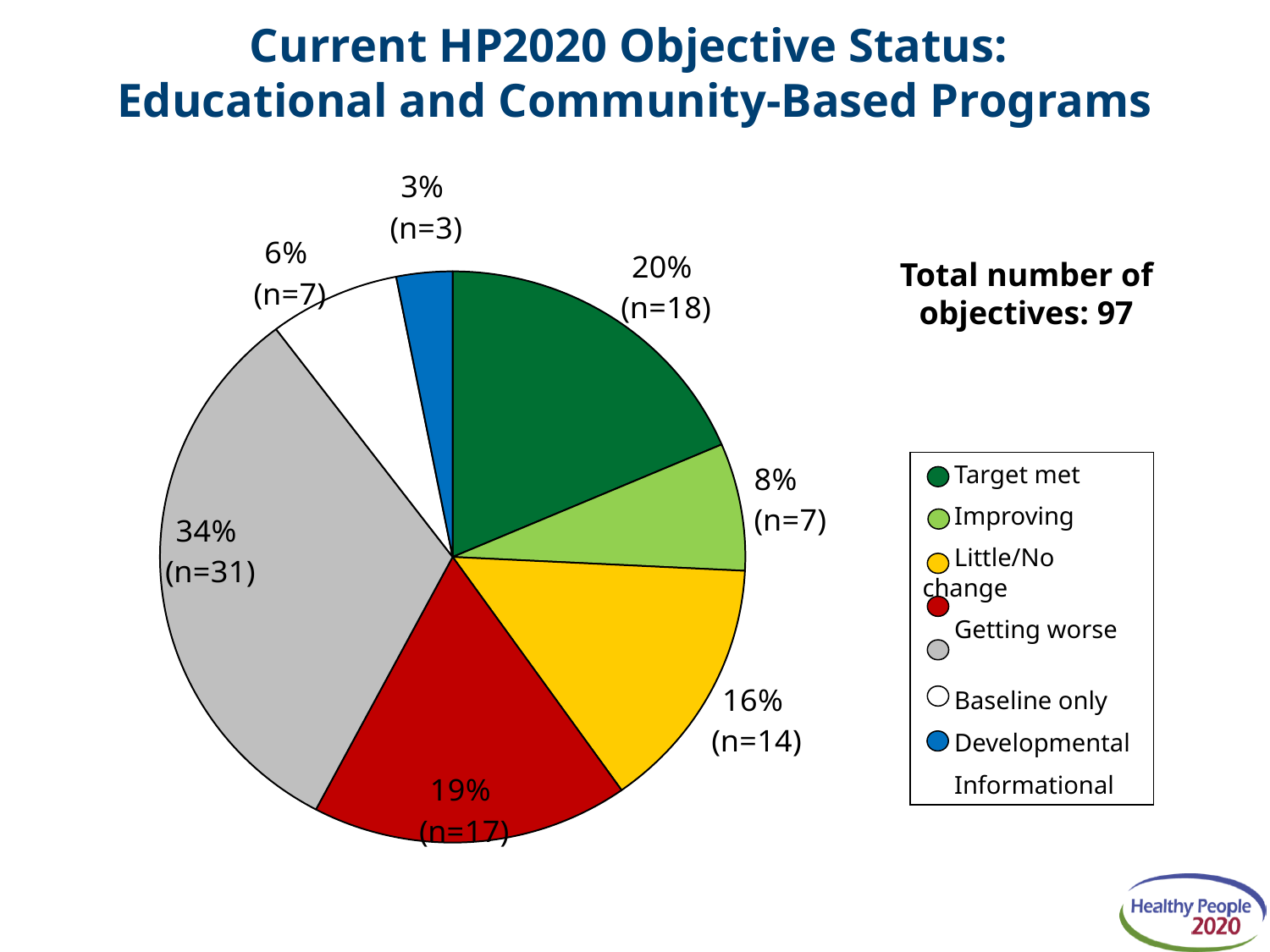
Which slice of the pie is the largest? the gray slice (34%, n=31) How many objectives are in the Improving category? 7 What percentage does the gray slice represent? 34% What kind of chart is shown on the slide? pie chart Which slice of the pie is the smallest? the blue slice (3%, n=3) Which is larger, the Target met slice or the Little/No change slice? Target met How many slices does the pie chart have? 7 How many objectives does the red slice represent? 17 What is the total number of objectives stated on the slide? 97 What percentage of objectives show Little/No change? 16% How many more objectives are in the Target met category than in the Improving category? 11 What percentage of objectives have the status Target met? 20%